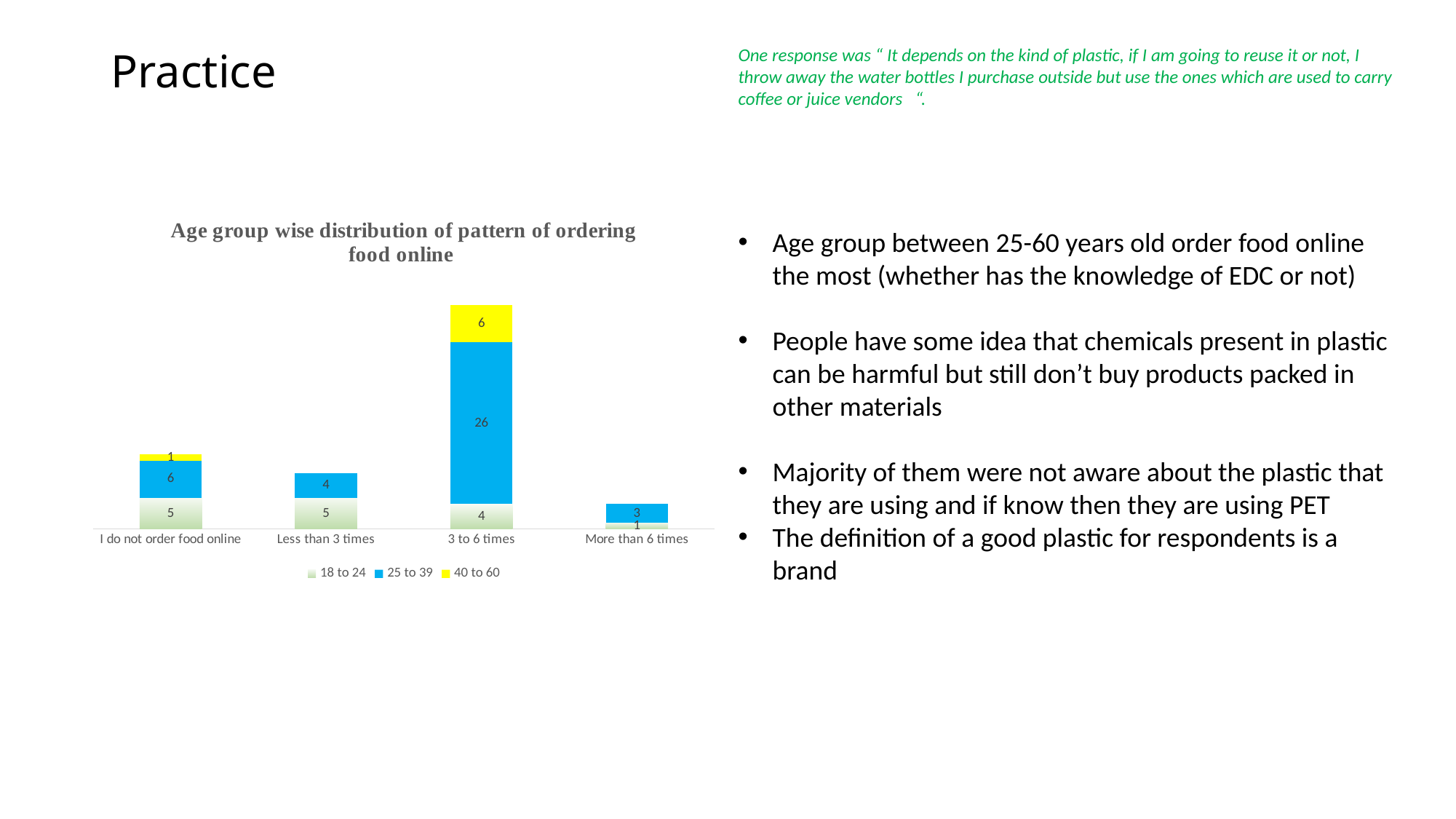
What is the total of the stacked bar for '3 to 6 times'? 36 What type of chart is shown on the slide? Stacked bar chart Which category has the tallest stacked bar? 3 to 6 times What is the value for the 40 to 60 age group in the 'I do not order food online' category? 1 How many categories are shown on the x axis? 4 Which category has the shortest stacked bar? More than 6 times What is the value for the 25 to 39 age group in the '3 to 6 times' category? 26 What is the title of the chart? Age group wise distribution of pattern of ordering food online What is the value for the 18 to 24 age group in the 'Less than 3 times' category? 5 Which is larger: the 25 to 39 value for 'Less than 3 times' or for 'More than 6 times'? Less than 3 times How many series does the legend list? 3 What is the difference between the 25 to 39 values for '3 to 6 times' and 'I do not order food online'? 20